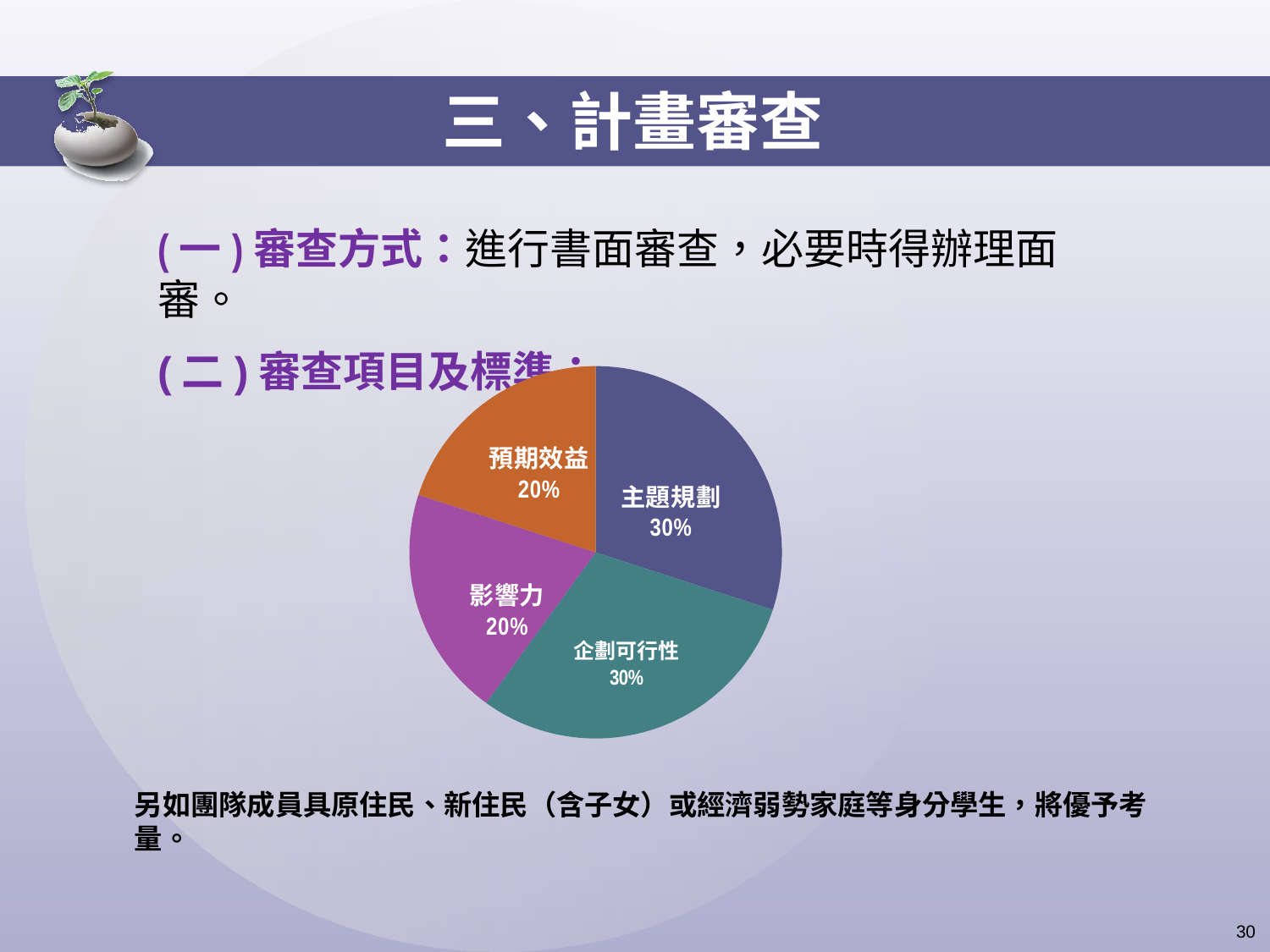
What percentage is shown for 企劃可行性 in the pie chart? 30% What percentage is shown for 預期效益 in the pie chart? 20% Which is larger in the pie chart, 預期效益 or 企劃可行性? 企劃可行性 What colour is the 預期效益 slice in the pie chart? orange What is the difference in percentage points between 主題規劃 and 預期效益 in the pie chart? 10 Which is larger in the pie chart, 主題規劃 or 影響力? 主題規劃 What percentage is shown for 影響力 in the pie chart? 20% What kind of chart is shown on the slide? pie chart What share of the pie does 影響力 represent? 20% How many slices does the pie chart have? 4 What percentage is shown for 主題規劃 in the pie chart? 30% What is the combined share of 主題規劃 and 企劃可行性 in the pie chart? 60%